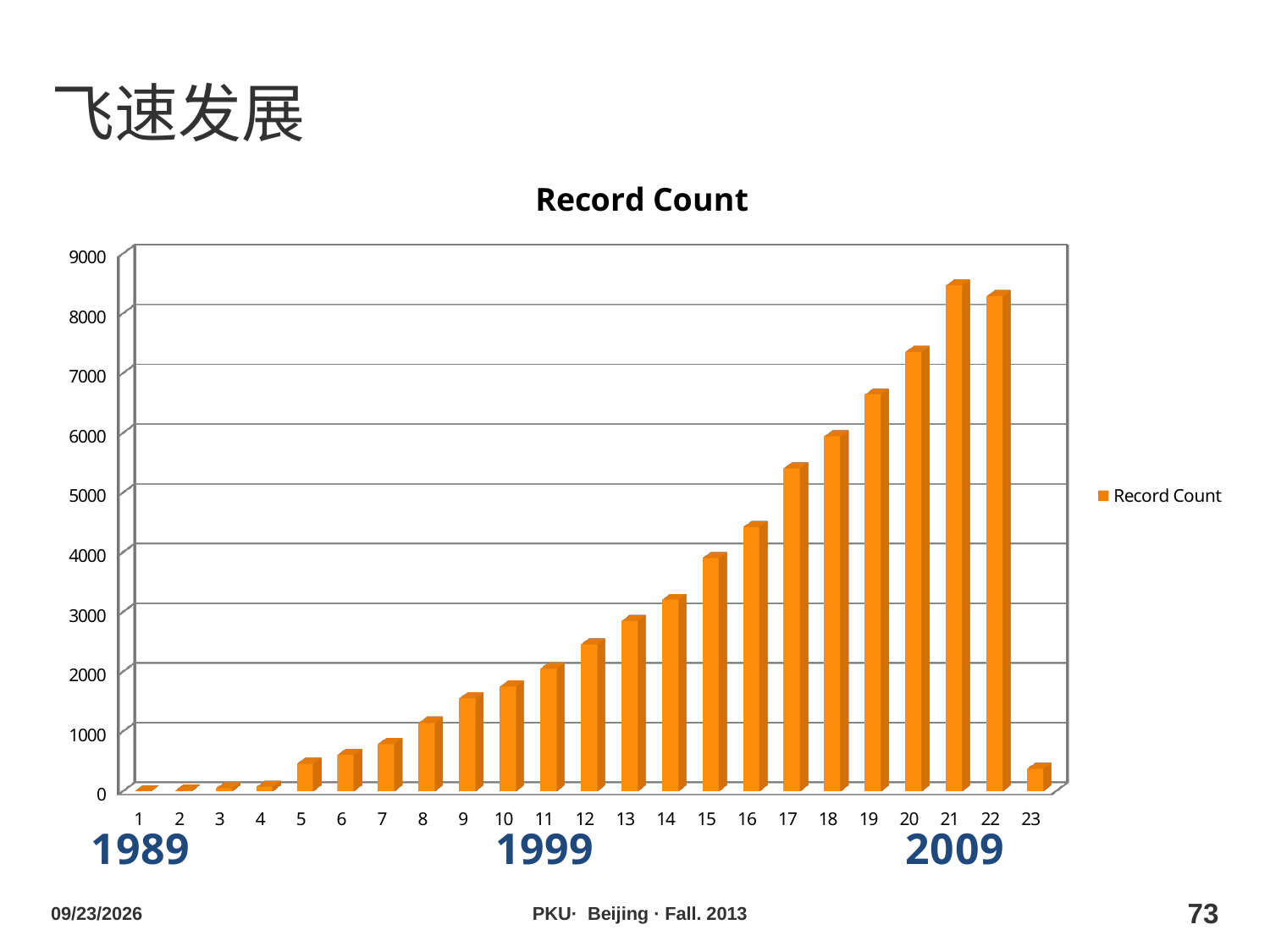
How many series does the legend list? 1 What is the title of the chart? Record Count What colour are the bars in the chart? orange How many categories are plotted along the x axis? 23 Which is larger, the value for category 19 or the value for category 16? 19 What kind of chart is shown on the slide? bar chart Is the value for category 20 greater or less than 7000? greater Is the value for category 23 greater or less than 1000? less Which category has the highest Record Count? 21 Do the values generally rise or fall from category 1 to category 21? rise Is the value for category 17 greater or less than 5000? greater